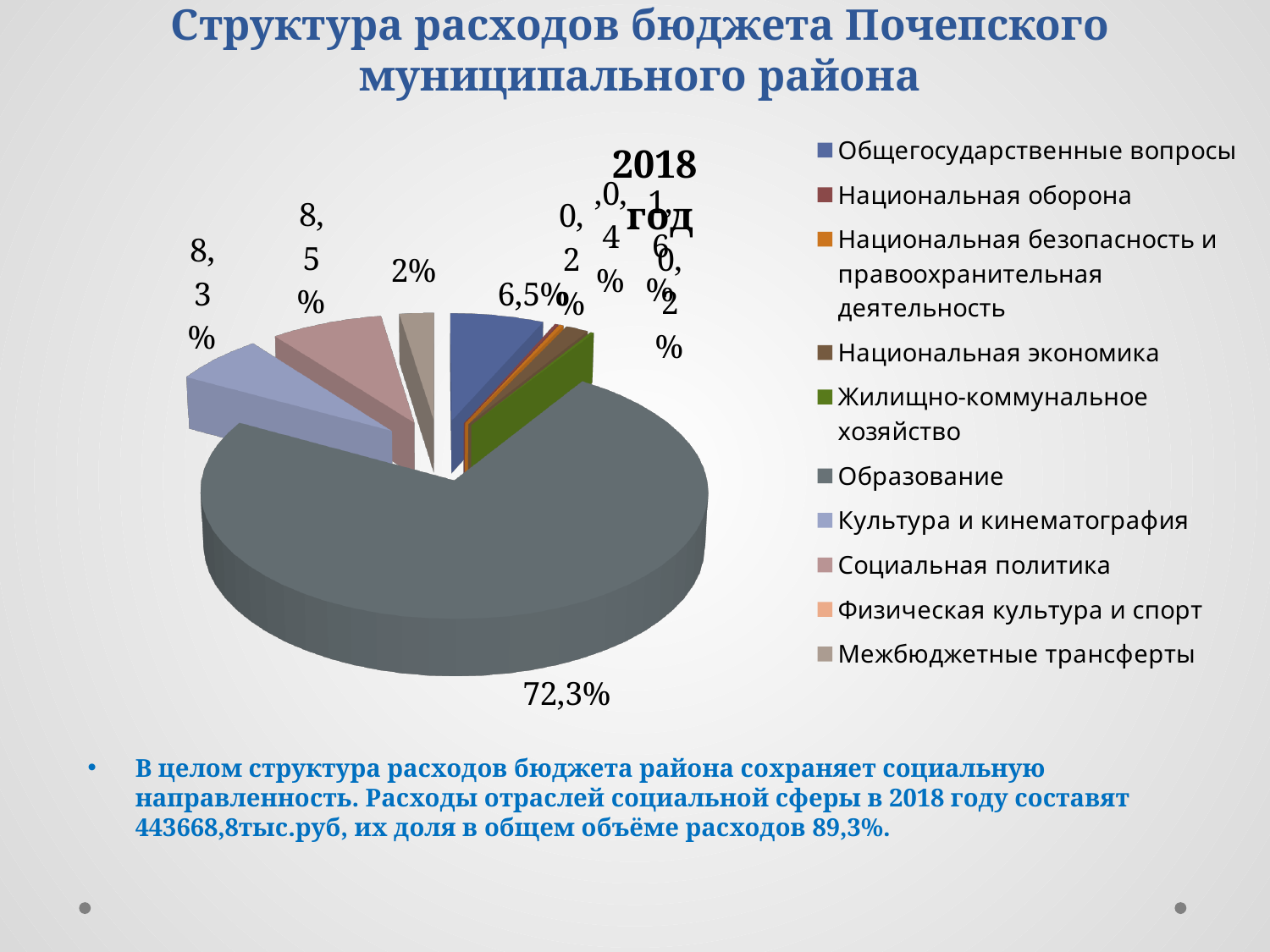
What share of the budget expenditure goes to Межбюджетные трансферты? 2% What share of the budget expenditure goes to Культура и кинематография? 8,3% What colour is the slice for Образование in the pie chart? Dark grey What kind of chart is shown on the slide? Pie chart What share of the budget expenditure goes to Социальная политика? 8,5% What share of the budget expenditure goes to Образование? 72,3% Which has a larger share: Общегосударственные вопросы or Межбюджетные трансферты? Общегосударственные вопросы What is the title of the pie chart? 2018 год By how many percentage points does the share of Образование exceed the share of Социальная политика? 63,8% What share of the budget expenditure goes to Общегосударственные вопросы? 6,5% How many categories does the legend of the pie chart list? 10 Which category has the largest share of the pie? Образование